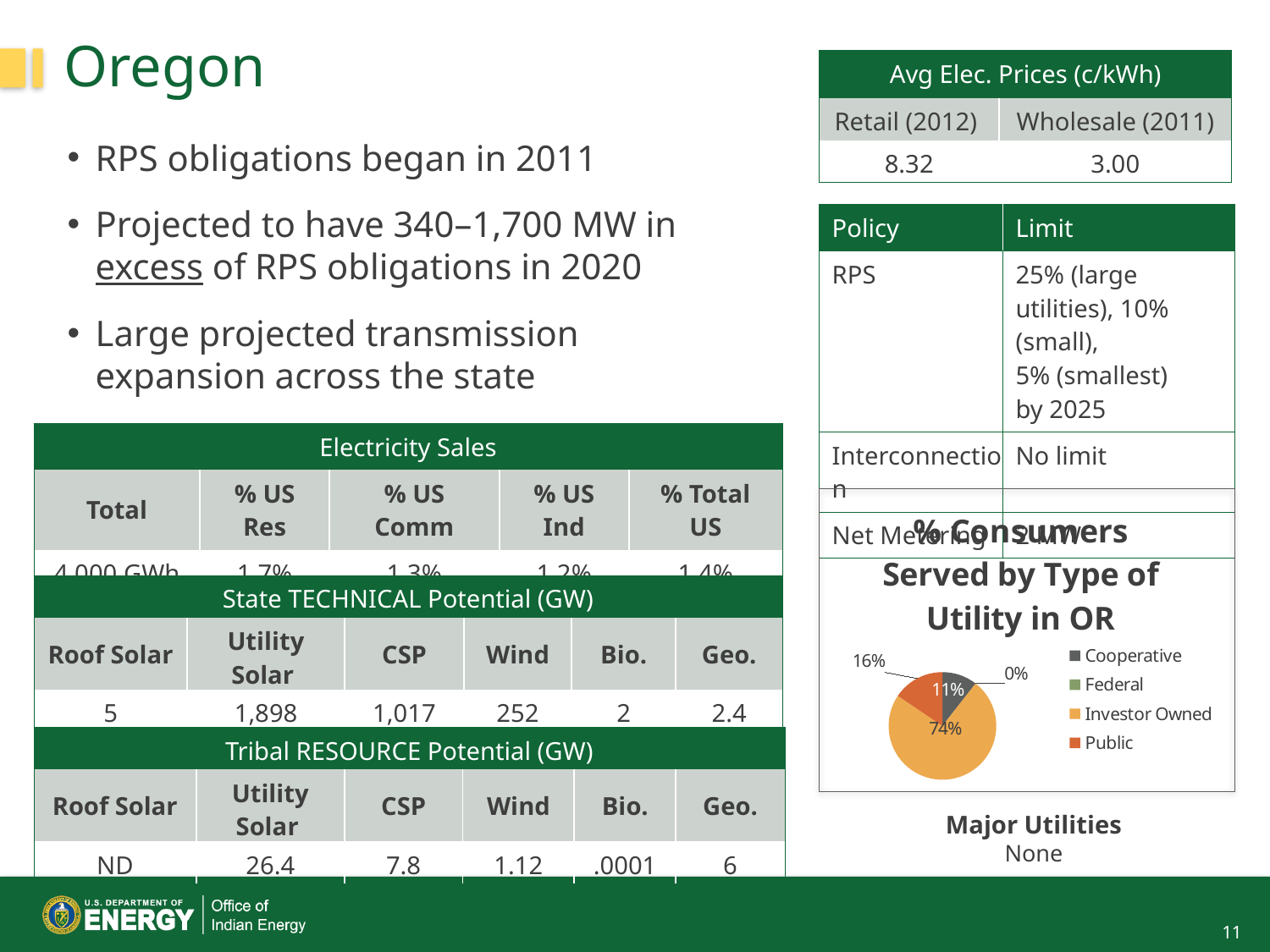
What kind of chart is shown on the slide? pie chart Which utility type serves the largest share of consumers in the pie chart? Investor Owned How many slices does the pie chart have? 4 What share of consumers is served by Public utilities in the pie chart? 16% How many utility types does the pie chart's legend list? 4 What share of consumers is served by Cooperative utilities in the pie chart? 11% What share of consumers is served by Federal utilities in the pie chart? 0% What is the title of the pie chart? % Consumers Served by Type of Utility in OR What share of consumers is served by Investor Owned utilities in the pie chart? 74% Which utility type serves the smallest share of consumers in the pie chart? Federal Which serves a larger share of consumers in the pie chart, Investor Owned or Public utilities? Investor Owned By how many percentage points does the Investor Owned share exceed the Federal share in the pie chart? 74